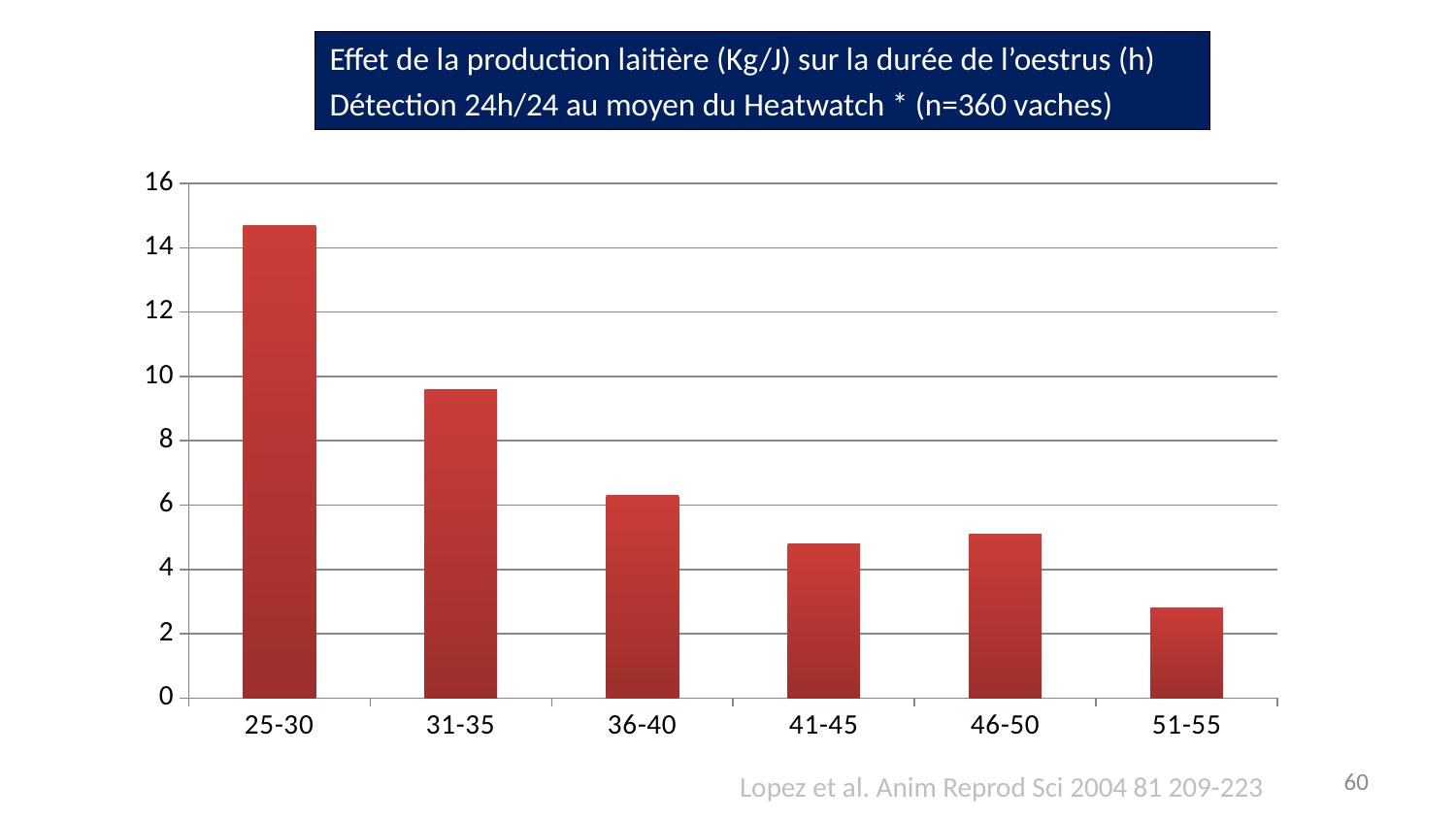
Which is larger, the value for 25-30 or the value for 31-35? 25-30 According to the title, how many cows were included in the study? 360 Is the value for 25-30 greater or less than 14? greater Overall, do the values rise or fall as milk production increases along the x axis? fall Which milk production category has the highest oestrus duration? 25-30 Which milk production category has the lowest oestrus duration? 51-55 Is the value for 51-55 greater or less than 4? less What kind of chart is shown on the slide? bar chart How many milk production categories are shown on the x axis? 6 Is the value for 31-35 greater or less than 10? less Which is larger, the value for 36-40 or the value for 51-55? 36-40